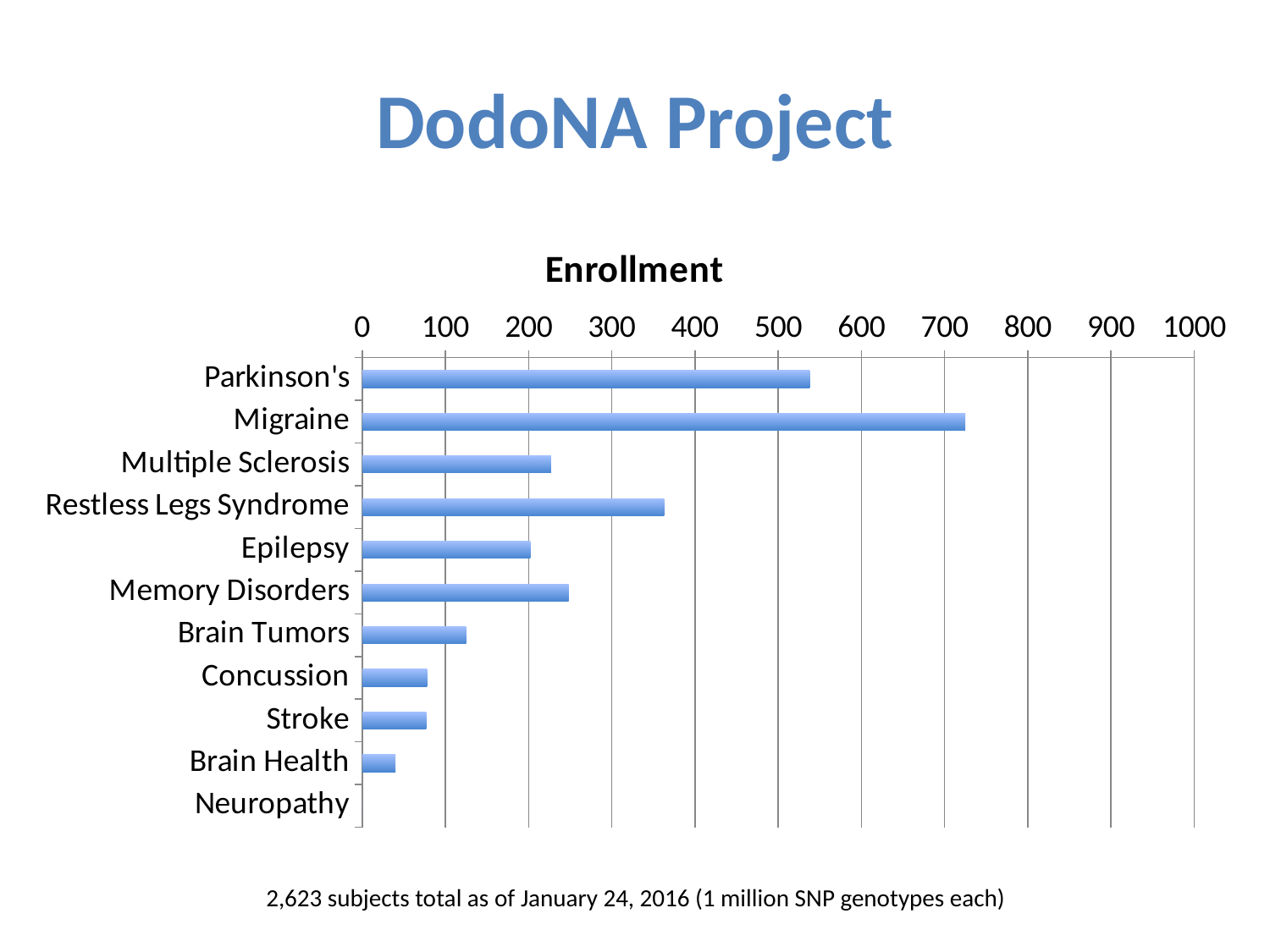
Is the value for Parkinson's greater or less than 500? greater How many categories are plotted in the chart? 11 Which category has the lowest enrollment? Neuropathy Is the value for Brain Health greater or less than 100? less Is the value for Restless Legs Syndrome greater or less than 400? less Which has a larger enrollment, Memory Disorders or Epilepsy? Memory Disorders Which category has the highest enrollment? Migraine What is the title of the chart? Enrollment Which has a larger enrollment, Parkinson's or Restless Legs Syndrome? Parkinson's What kind of chart is shown on the slide? bar chart